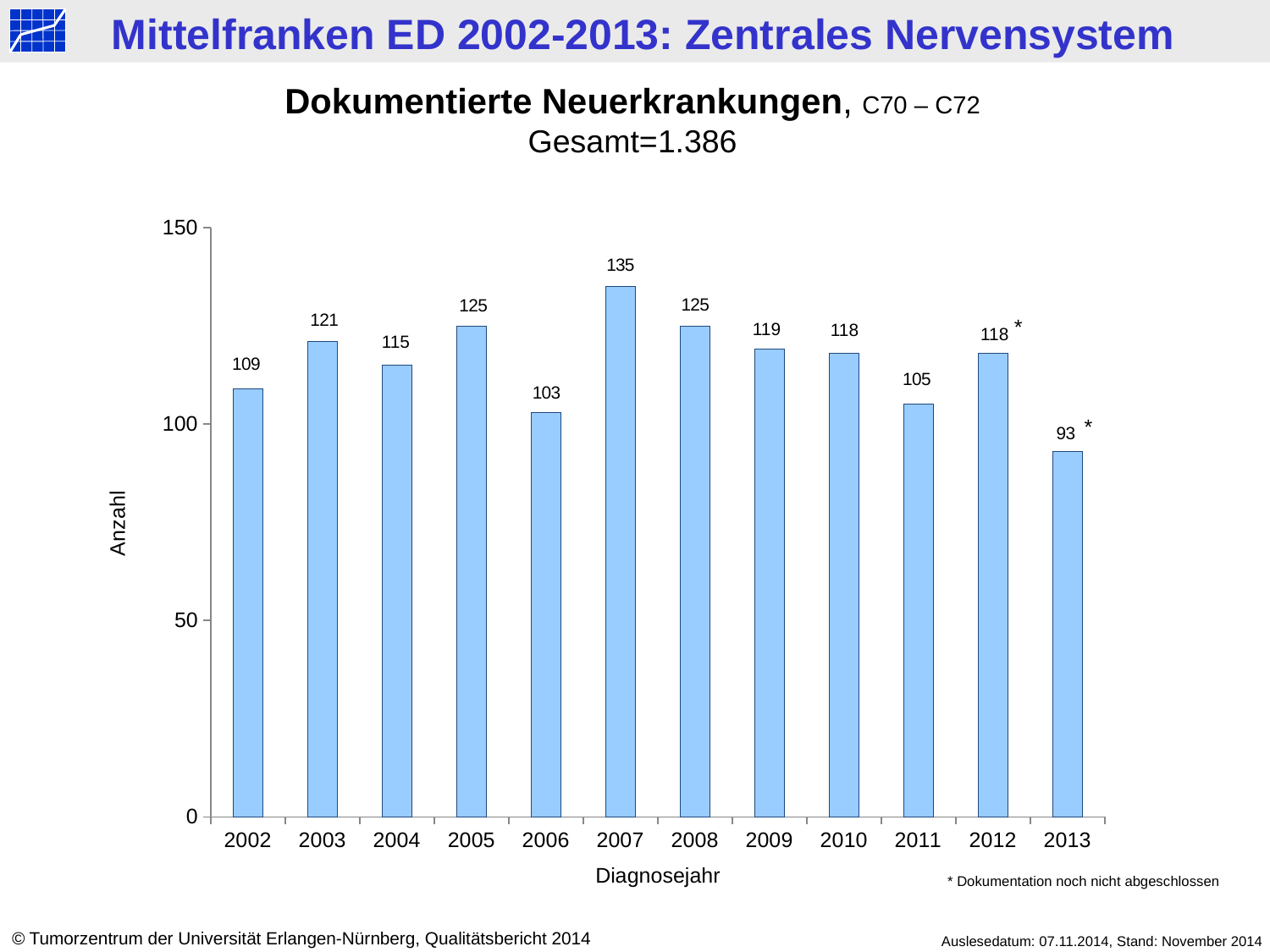
What kind of chart is shown? bar chart How many years are shown on the x axis? 12 Is the value for 2011 greater or less than 100? greater Which year has the lowest value? 2013 Which year has the highest value? 2007 Which is larger, the value for 2003 or the value for 2004? 2003 What is the label of the y axis? Anzahl What is the difference between the values for 2007 and 2006? 32 What is the value for 2013? 93 What is the value for 2007? 135 What total (Gesamt) is stated above the chart? 1.386 What is the value for 2002? 109